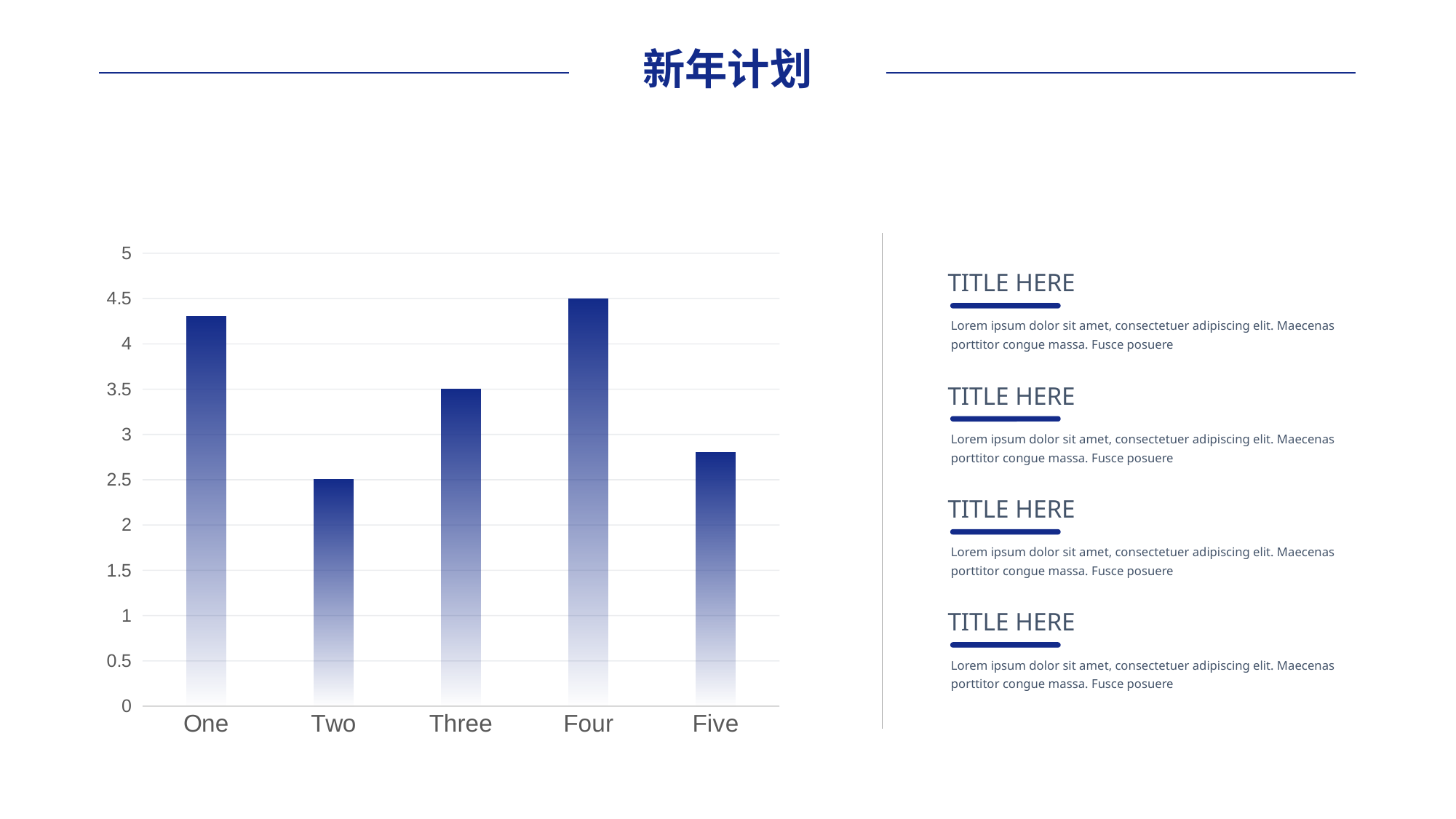
How many categories are shown on the x axis of the chart? 5 What is the value for Two? 2.5 Which category has the highest value? Four What type of chart is shown on the slide? bar chart What is the difference between the values for Four and Two? 2 Which category has the lowest value? Two Is the value for Five greater or less than 3? less Is the value for One greater or less than 4? greater What is the title of the slide containing the chart? 新年计划 What is the value for Four? 4.5 What is the difference between the values for Four and Three? 1 What is the value for Three? 3.5